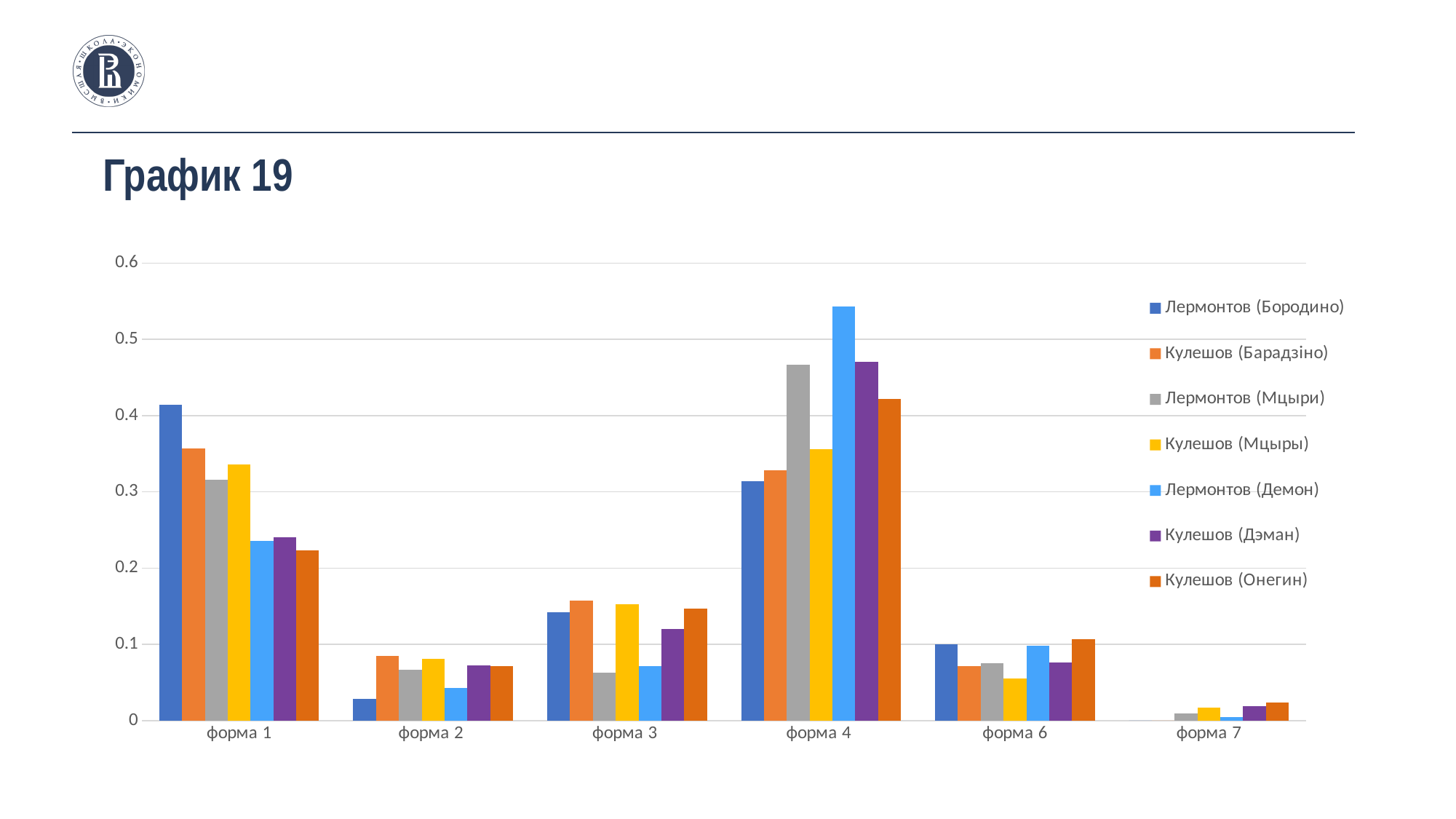
Is the value for Лермонтов (Демон) at форма 4 greater or less than 0.5? greater How many categories are shown on the x axis of the chart? 6 Is the value for Лермонтов (Мцыри) at форма 4 greater or less than 0.4? greater What is the title of the slide containing the chart? График 19 Which series is shown in yellow in the chart's legend? Кулешов (Мцыры) Is the value for Кулешов (Мцыры) at форма 3 greater or less than 0.1? greater For Лермонтов (Бородино), which is larger: the value at форма 1 or at форма 4? форма 1 Which series has the highest value at форма 4? Лермонтов (Демон) What kind of chart is shown on the slide? bar chart Which series has the highest value at форма 1? Лермонтов (Бородино) How many series does the chart's legend list? 7